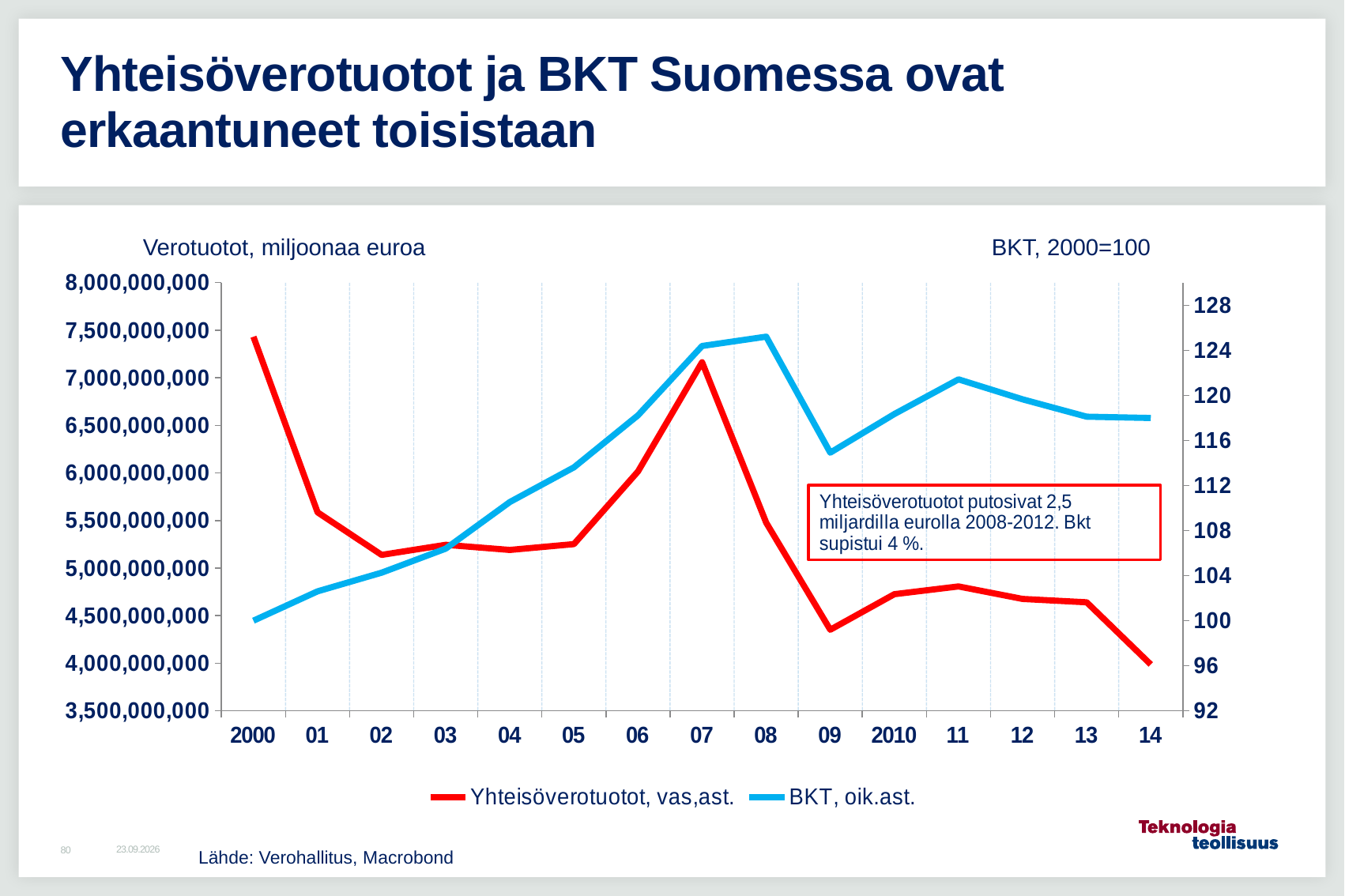
Does the BKT series rise or fall from 2000 to 07? rise What kind of chart is shown on the slide? line chart In which year is the Yhteisöverotuotot series at its highest? 2000 How many years are plotted along the x axis? 15 In which year is the Yhteisöverotuotot series at its lowest? 14 Is the Yhteisöverotuotot value for 14 greater or less than 4,500,000,000? less In which year is the BKT series at its lowest? 2000 What is the label of the right-hand axis? BKT, 2000=100 Is the Yhteisöverotuotot value for 07 greater or less than 7,000,000,000? greater Is the BKT value for 2000 greater or less than 104? less How many series does the legend list? 2 Which year has the larger Yhteisöverotuotot value, 2000 or 09? 2000